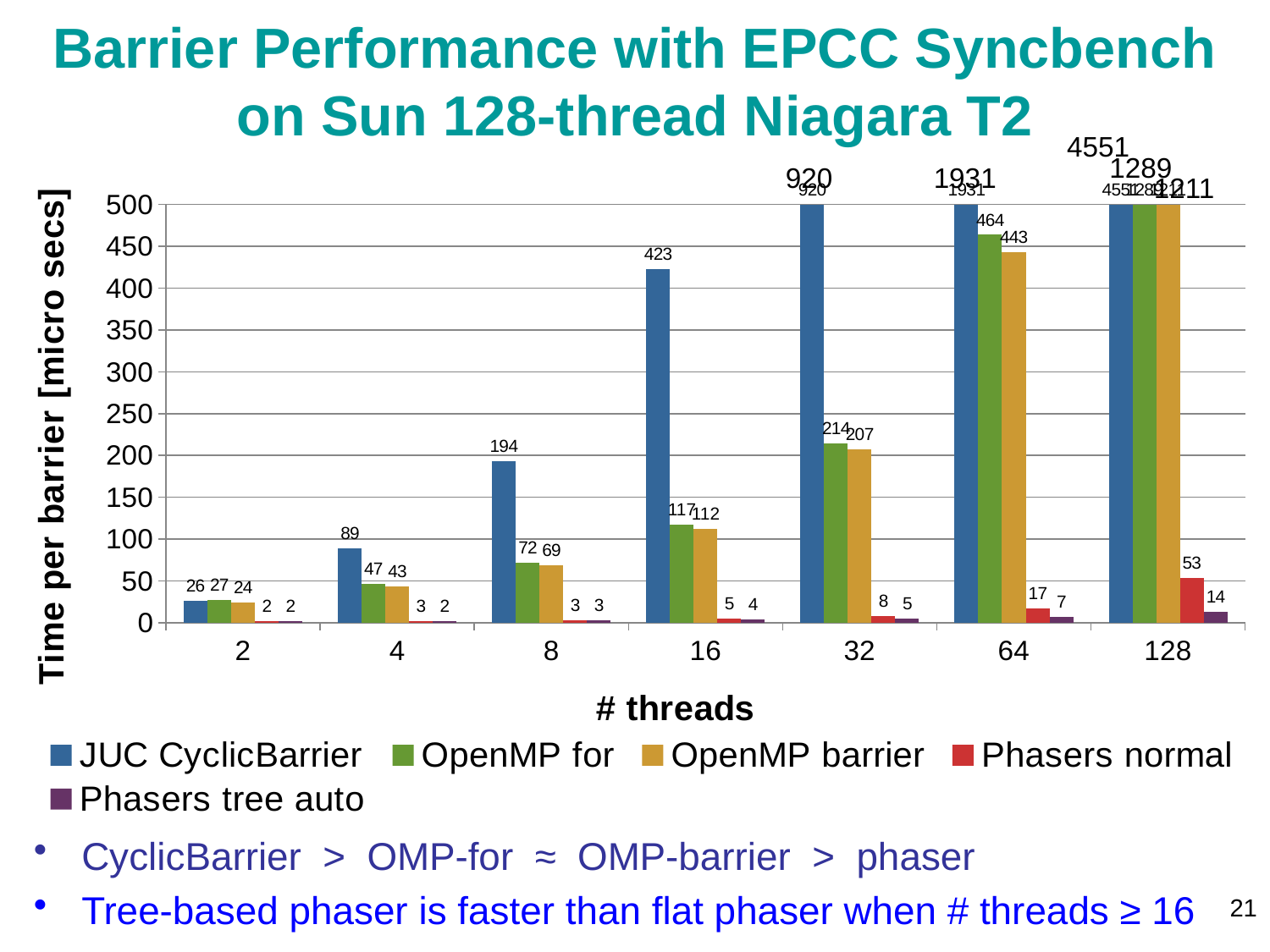
What is the time per barrier for JUC CyclicBarrier at 16 threads? 423 How many series does the legend list? 5 Which series has the lowest value at 64 threads? Phasers tree auto Does the JUC CyclicBarrier time rise or fall as the number of threads increases? Rises What kind of chart is shown on the slide? Bar chart How many thread-count categories are shown on the x axis? 7 What is the value for OpenMP for at 64 threads? 464 What is the value for Phasers normal at 128 threads? 53 What is the difference between OpenMP for and OpenMP barrier at 32 threads? 7 What is the value for JUC CyclicBarrier at 32 threads? 920 Which series has the highest value at 32 threads? JUC CyclicBarrier At 128 threads, which is larger: Phasers normal or Phasers tree auto? Phasers normal